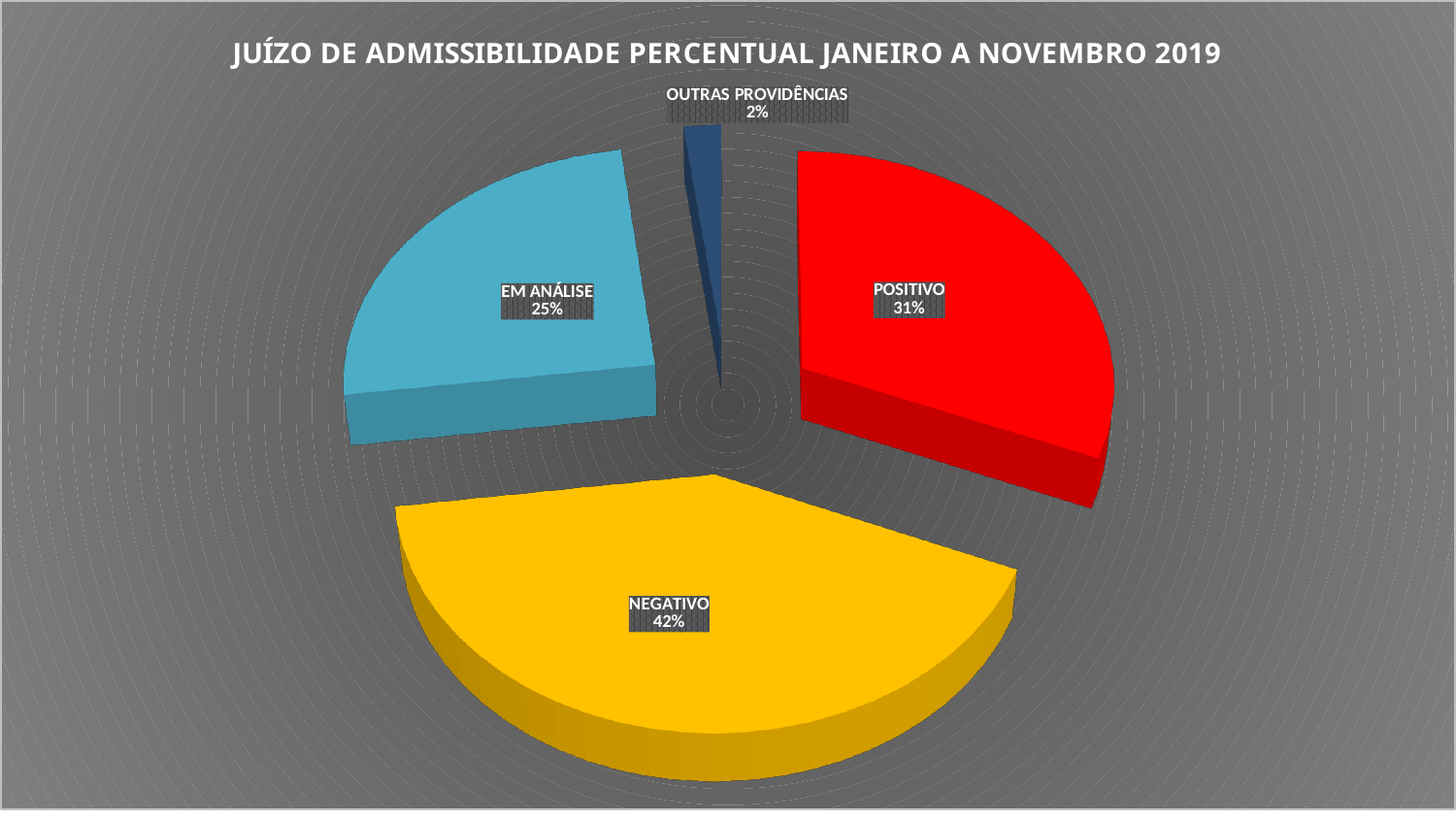
What percentage is shown for EM ANÁLISE? 25% What is the title of the chart? JUÍZO DE ADMISSIBILIDADE PERCENTUAL JANEIRO A NOVEMBRO 2019 Which category has the largest share of the pie? NEGATIVO What is the difference in percentage points between NEGATIVO and POSITIVO? 11 What percentage is shown for OUTRAS PROVIDÊNCIAS? 2% What percentage is shown for POSITIVO? 31% What kind of chart is shown on the slide? Pie chart How many categories are shown in the pie chart? 4 Which is larger, the share for POSITIVO or the share for EM ANÁLISE? POSITIVO Which category has the smallest share of the pie? OUTRAS PROVIDÊNCIAS What colour is the NEGATIVO slice? Yellow What percentage is shown for NEGATIVO? 42%